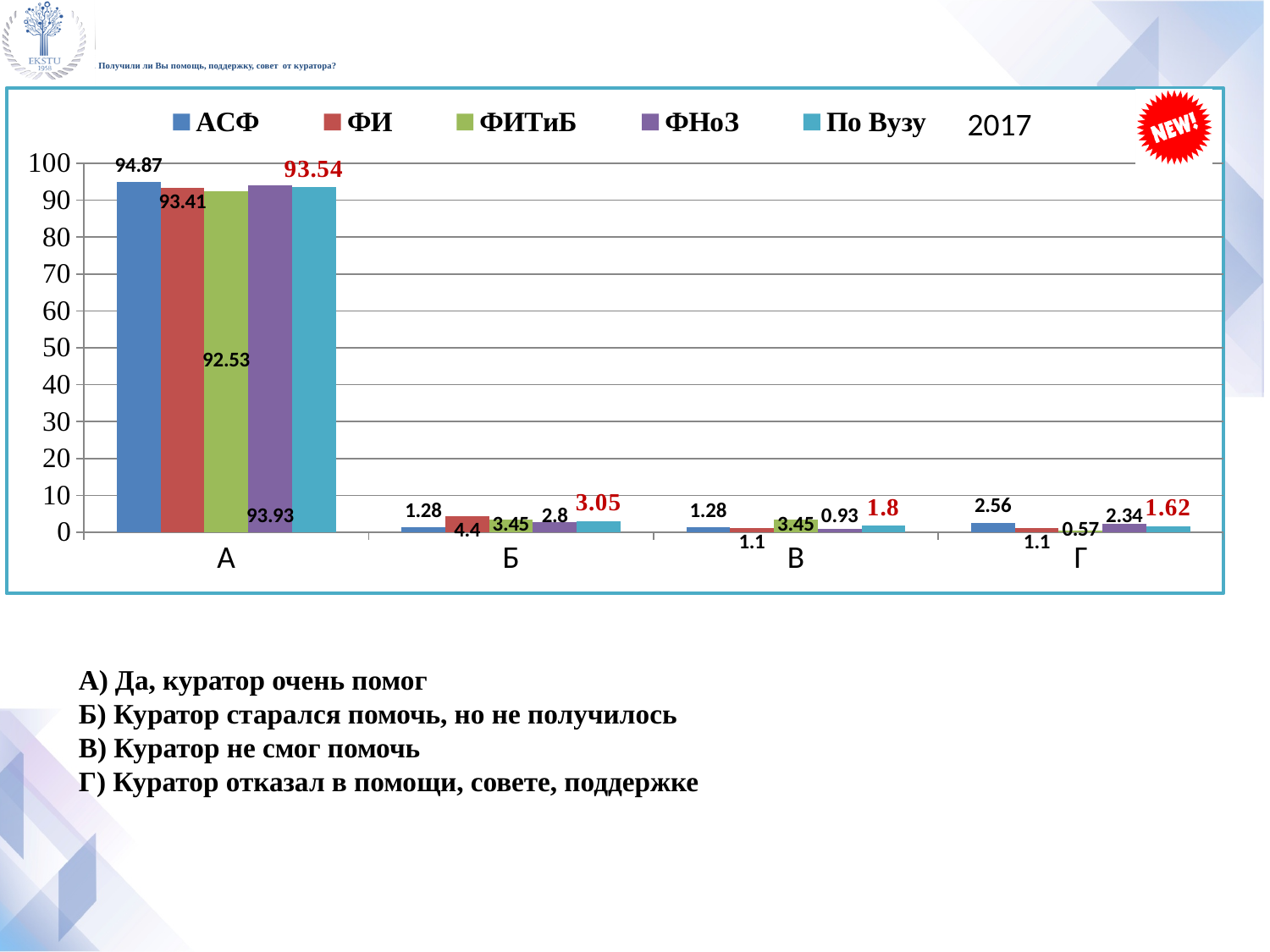
Which year is indicated next to the legend of the chart? 2017 What kind of chart is shown on the slide? bar chart How many series does the legend list? 5 Which series has the lowest value in category Г? ФИТиБ What is the value for По Вузу in category Б? 3.05 Which series has the highest value in category Б? ФИ What is the difference between the АСФ value and the ФИТиБ value in category А? 2.34 What is the value for ФНоЗ in category В? 0.93 Which is larger in category В: the value for ФИТиБ or the value for По Вузу? ФИТиБ How many categories are shown on the x axis? 4 What is the value for АСФ in category А? 94.87 What is the value for ФИТиБ in category Г? 0.57